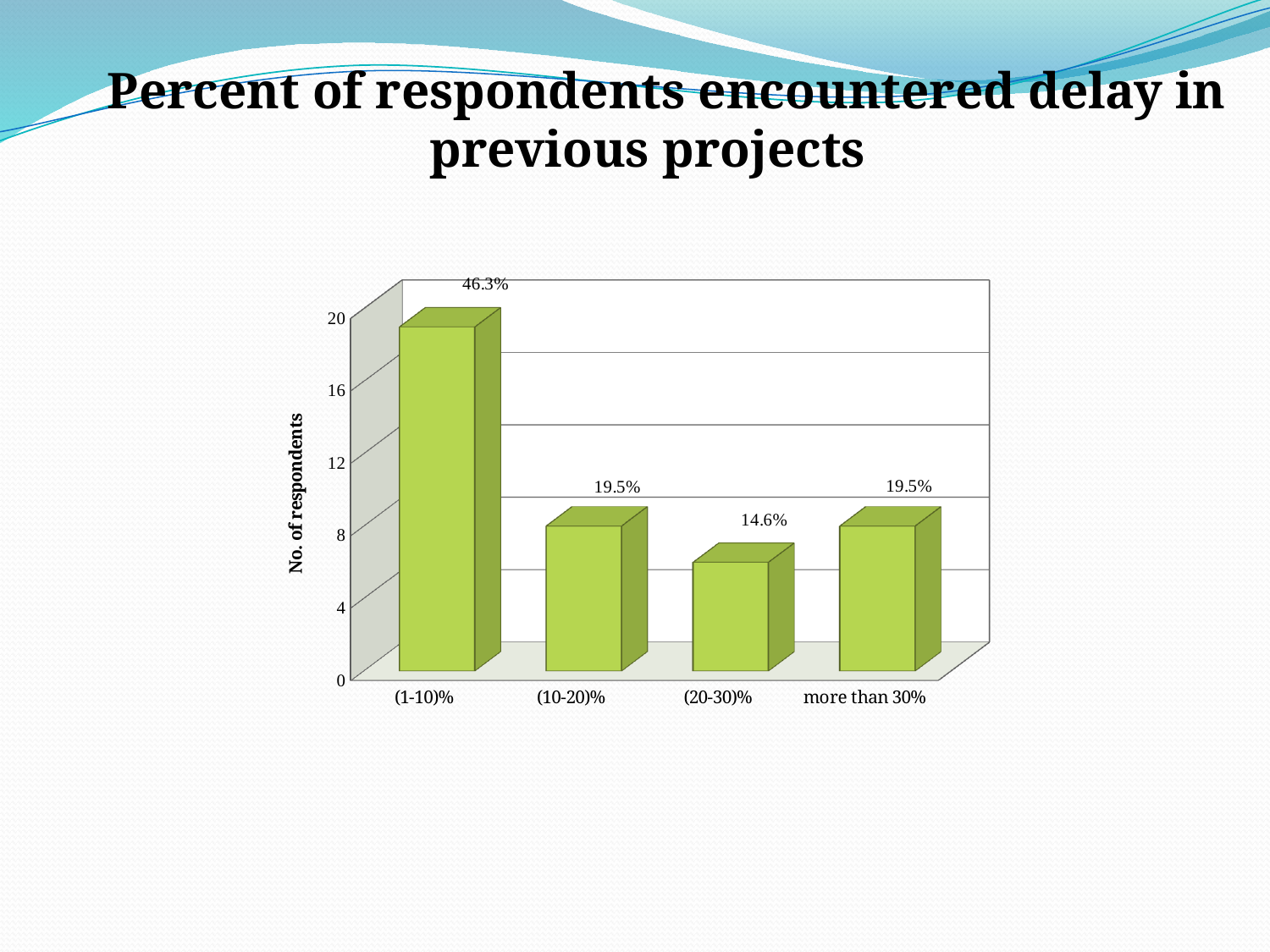
Is the number of respondents for (1-10)% greater or less than 16? greater How many categories are shown on the x axis? 4 What data label is shown on the bar for (20-30)%? 14.6% What data label is shown on the bar for (10-20)%? 19.5% What data label is shown on the bar for (1-10)%? 46.3% Is the number of respondents for (20-30)% greater or less than 8? less Which category has the highest bar? (1-10)% What kind of chart is shown on the slide? Bar chart What data label is shown on the bar for more than 30%? 19.5% Which is larger, the bar for (1-10)% or the bar for (20-30)%? (1-10)% Which category has the lowest bar? (20-30)% What is the difference between the data labels for (1-10)% and (10-20)%? 26.8%